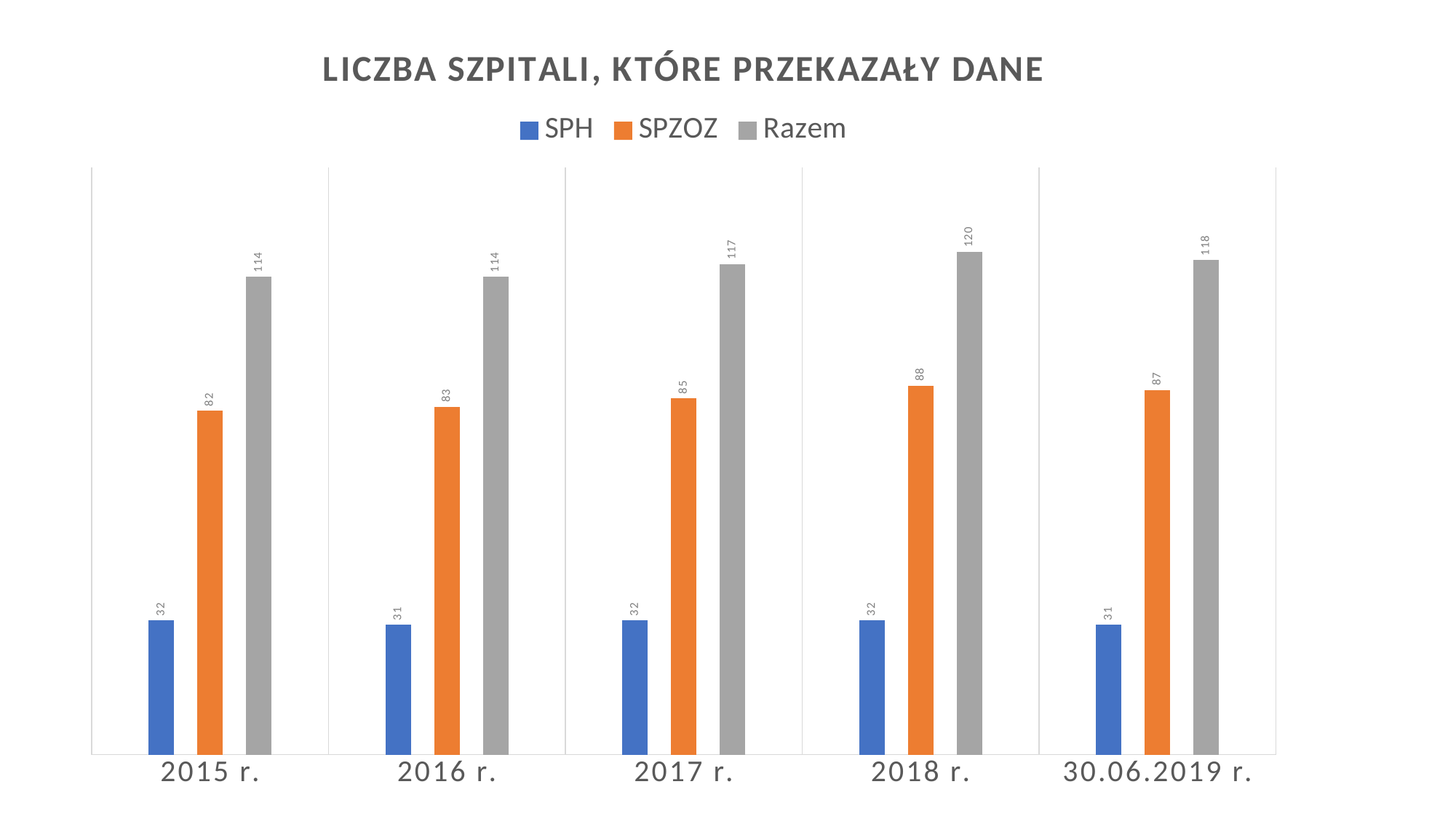
What is the difference between the SPZOZ and SPH values in 2018 r.? 56 What is the value for SPZOZ in 2017 r.? 85 In which category is the Razem value highest? 2018 r. What is the difference between the Razem values for 2018 r. and 2015 r.? 6 How many categories are shown on the x axis? 5 What is the value for Razem in 30.06.2019 r.? 118 What kind of chart is this? bar chart Which is larger, the SPZOZ value in 2016 r. or the SPZOZ value in 30.06.2019 r.? 30.06.2019 r. What is the value for SPH in 2016 r.? 31 In which category is the SPZOZ value lowest? 2015 r. How many series does the legend list? 3 What is the title of the chart? LICZBA SZPITALI, KTÓRE PRZEKAZAŁY DANE